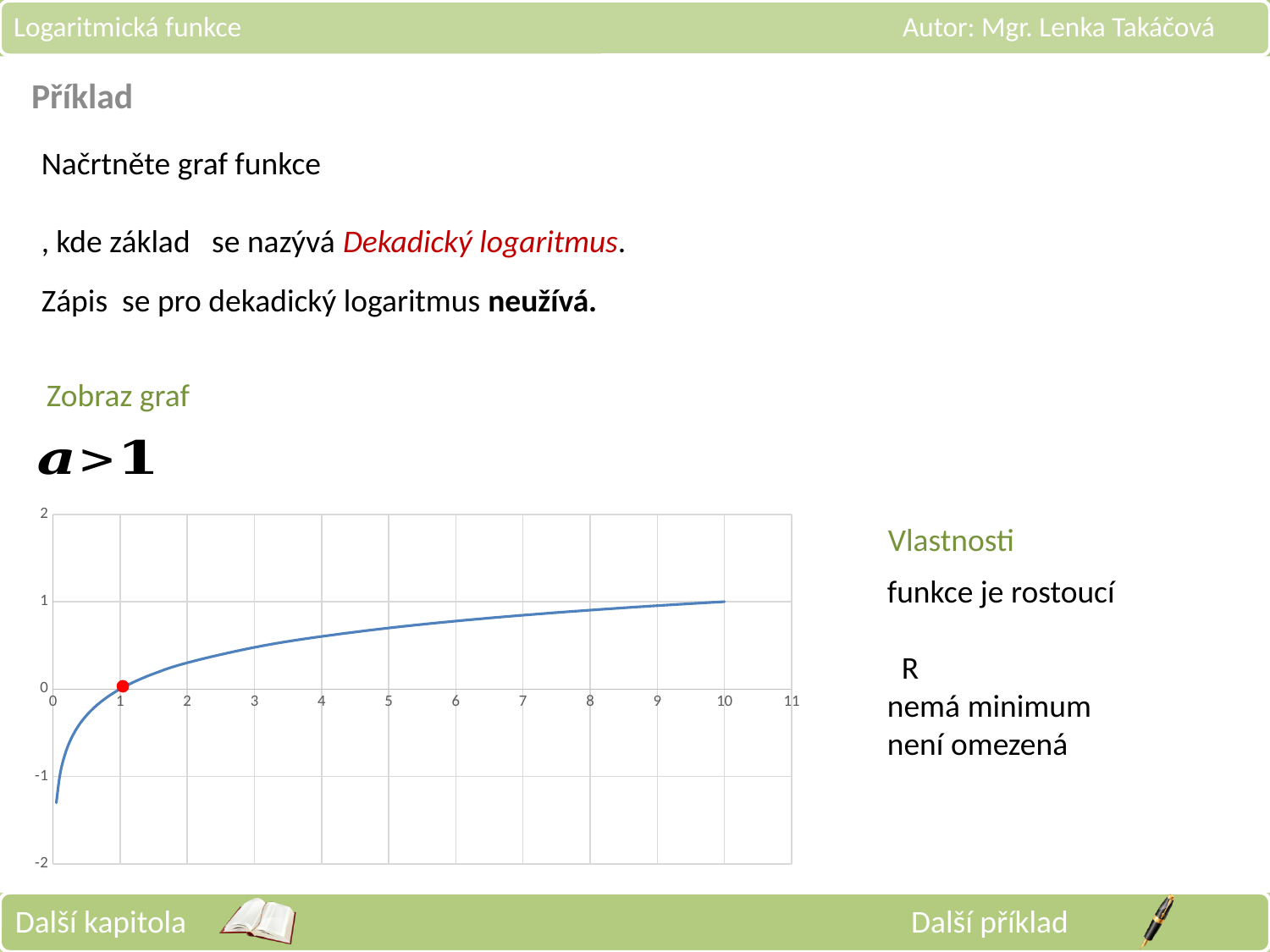
Is the value of the curve at x = 5 greater or less than 1? less Is the value of the curve at x = 2 greater or less than 0? greater What is the lowest tick label shown on the y axis? -2 Does the plotted curve rise or fall as x increases? rises What is the highest tick label shown on the x axis? 11 Is the value of the curve at x = 0.5 greater or less than 0? less Which is larger, the curve's value at x = 3 or at x = 9? x = 9 What is the y value of the curve at x = 10, its right end? 1 What kind of chart is shown on the slide? line chart What is the y value of the curve at x = 1, where the red point is marked? 0 At which x value does the curve reach its highest plotted value? 10